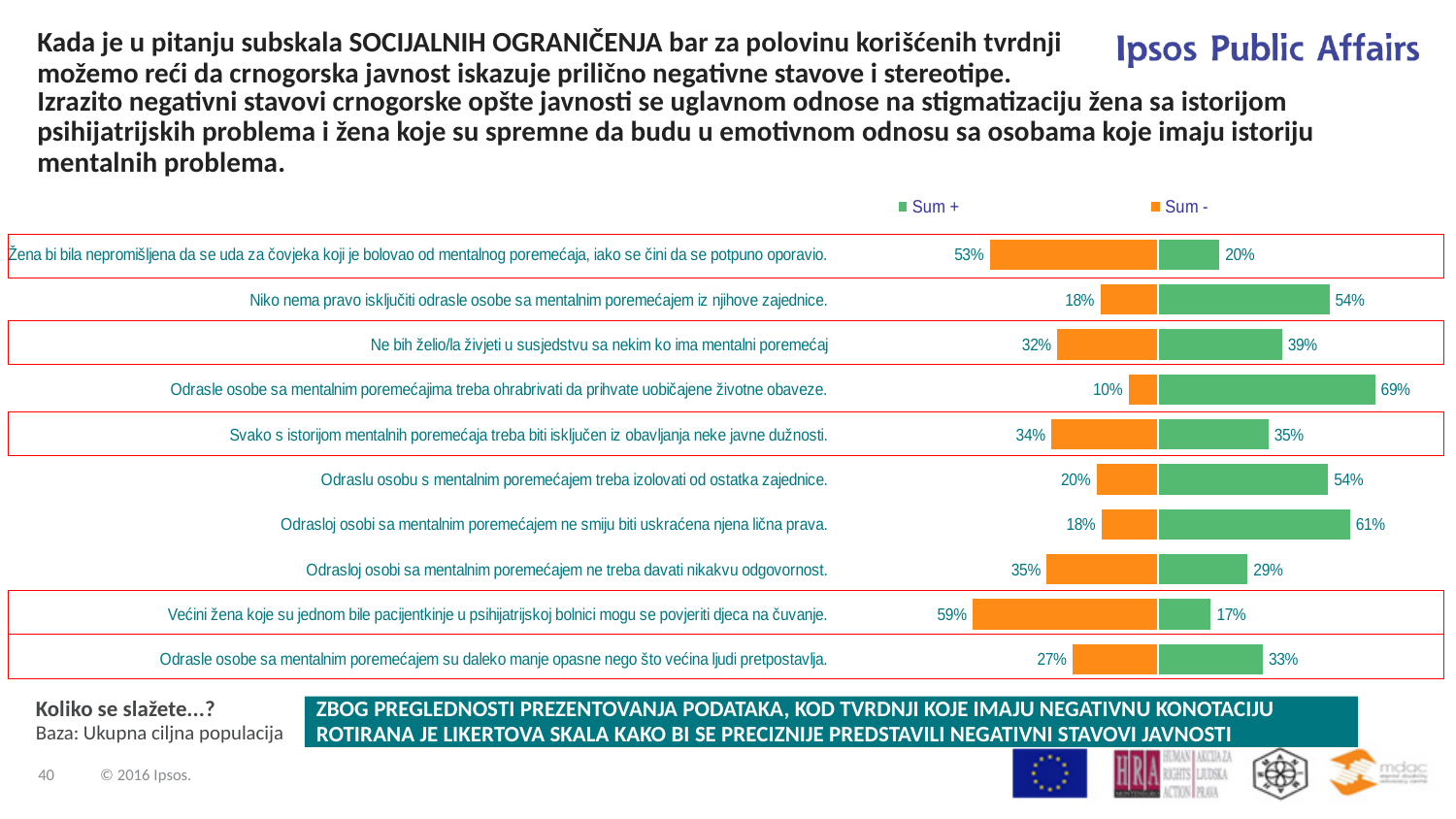
Which statement has the lowest Sum - value? Odrasle osobe sa mentalnim poremećajima treba ohrabrivati da prihvate uobičajene životne obaveze. Which statement has the highest Sum + value? Odrasle osobe sa mentalnim poremećajima treba ohrabrivati da prihvate uobičajene životne obaveze. Which colour represents the Sum - series in the chart? orange How many statements (categories) are plotted in the chart? 10 Which statement has the highest Sum - value? Većini žena koje su jednom bile pacijentkinje u psihijatrijskoj bolnici mogu se povjeriti djeca na čuvanje. What is the Sum + value for the statement "Odrasle osobe sa mentalnim poremećajima treba ohrabrivati da prihvate uobičajene životne obaveze."? 69% For the statement "Odrasloj osobi sa mentalnim poremećajem ne treba davati nikakvu odgovornost.", which is larger, Sum + or Sum -? Sum - How many series does the chart legend list? 2 What is the Sum + value for the statement "Odrasloj osobi sa mentalnim poremećajem ne smiju biti uskraćena njena lična prava."? 61% What type of chart is shown on the slide? bar chart What is the Sum - value for the statement "Većini žena koje su jednom bile pacijentkinje u psihijatrijskoj bolnici mogu se povjeriti djeca na čuvanje."? 59% What is the difference between the Sum - and Sum + values for the statement "Žena bi bila nepromišljena da se uda za čovjeka koji je bolovao od mentalnog poremećaja, iako se čini da se potpuno oporavio."? 33%